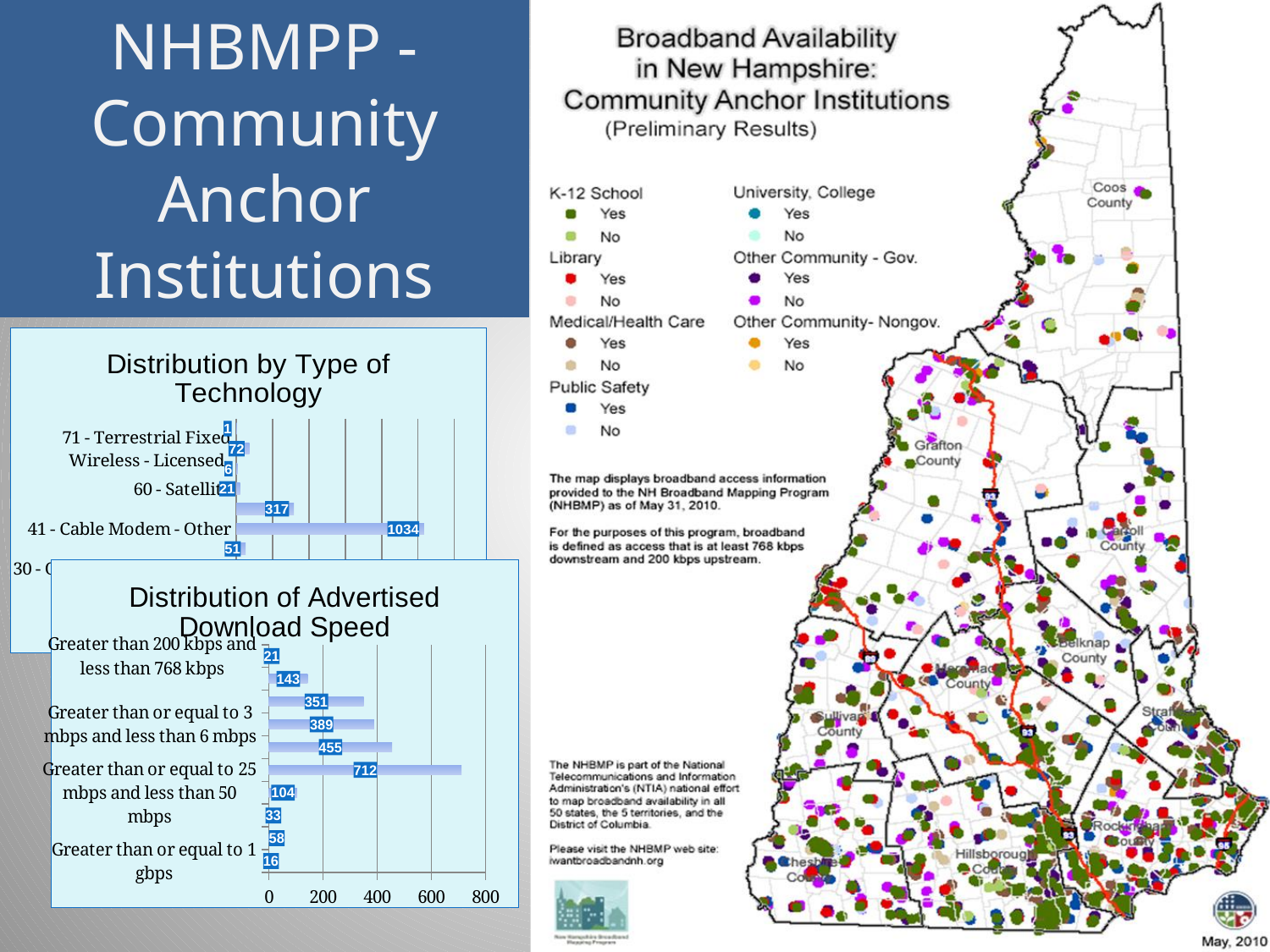
In the 'Distribution of Advertised Download Speed' chart, what is the value for 'Greater than or equal to 25 mbps and less than 50 mbps'? 104 What kind of chart is 'Distribution by Type of Technology'? bar chart In the 'Distribution by Type of Technology' chart, what is the largest value shown on any bar? 1034 In the 'Distribution of Advertised Download Speed' chart, what is the smallest value shown on any bar? 16 What kind of chart is 'Distribution of Advertised Download Speed'? bar chart In the 'Distribution by Type of Technology' chart, what is the value for '60 - Satellite'? 21 In the 'Distribution of Advertised Download Speed' chart, how many bars are plotted? 10 In the 'Distribution of Advertised Download Speed' chart, is the bar labelled 712 greater or less than 600 on the axis? greater In the 'Distribution of Advertised Download Speed' chart, what is the largest value shown on any bar? 712 In the 'Distribution of Advertised Download Speed' chart, what is the value for 'Greater than or equal to 1 gbps'? 16 In the 'Distribution of Advertised Download Speed' chart, what is the value for 'Greater than 200 kbps and less than 768 kbps'? 21 In the 'Distribution of Advertised Download Speed' chart, what is the difference between the bar labelled 712 and the bar labelled 455? 257